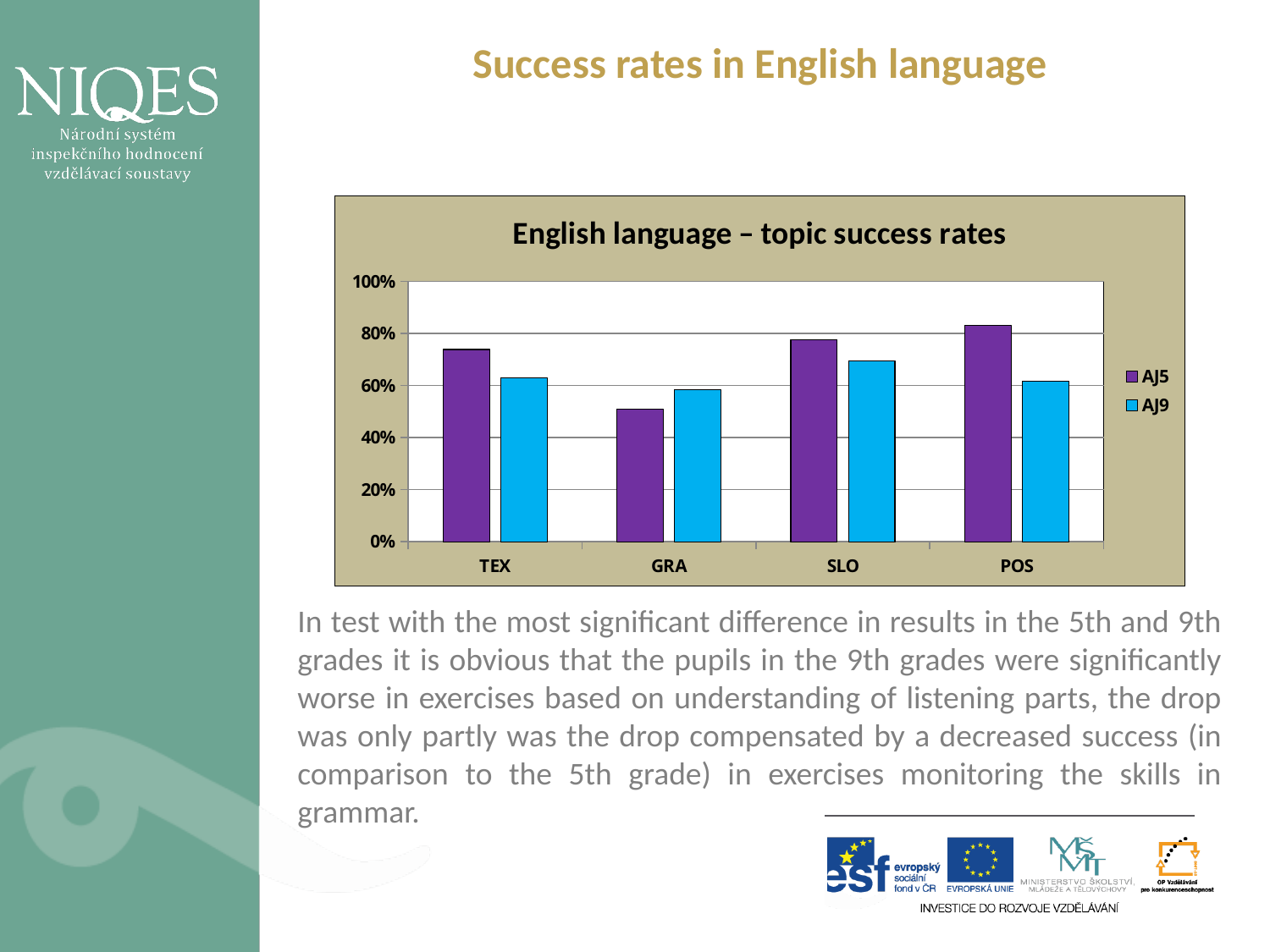
For the GRA category, which series has the larger value, AJ5 or AJ9? AJ9 What kind of chart is shown on the slide? bar chart Which category has the lowest value for the AJ5 series? GRA How many series does the chart legend list? 2 Which category has the highest value for the AJ5 series? POS Which category has the lowest value for the AJ9 series? GRA For the POS category, which series has the larger value, AJ5 or AJ9? AJ5 Which category has the highest value for the AJ9 series? SLO What is the title of the chart? English language – topic success rates Which series is shown in purple in the chart? AJ5 How many categories are shown on the x axis of the chart? 4 Is the AJ5 value for POS greater or less than 80%? greater